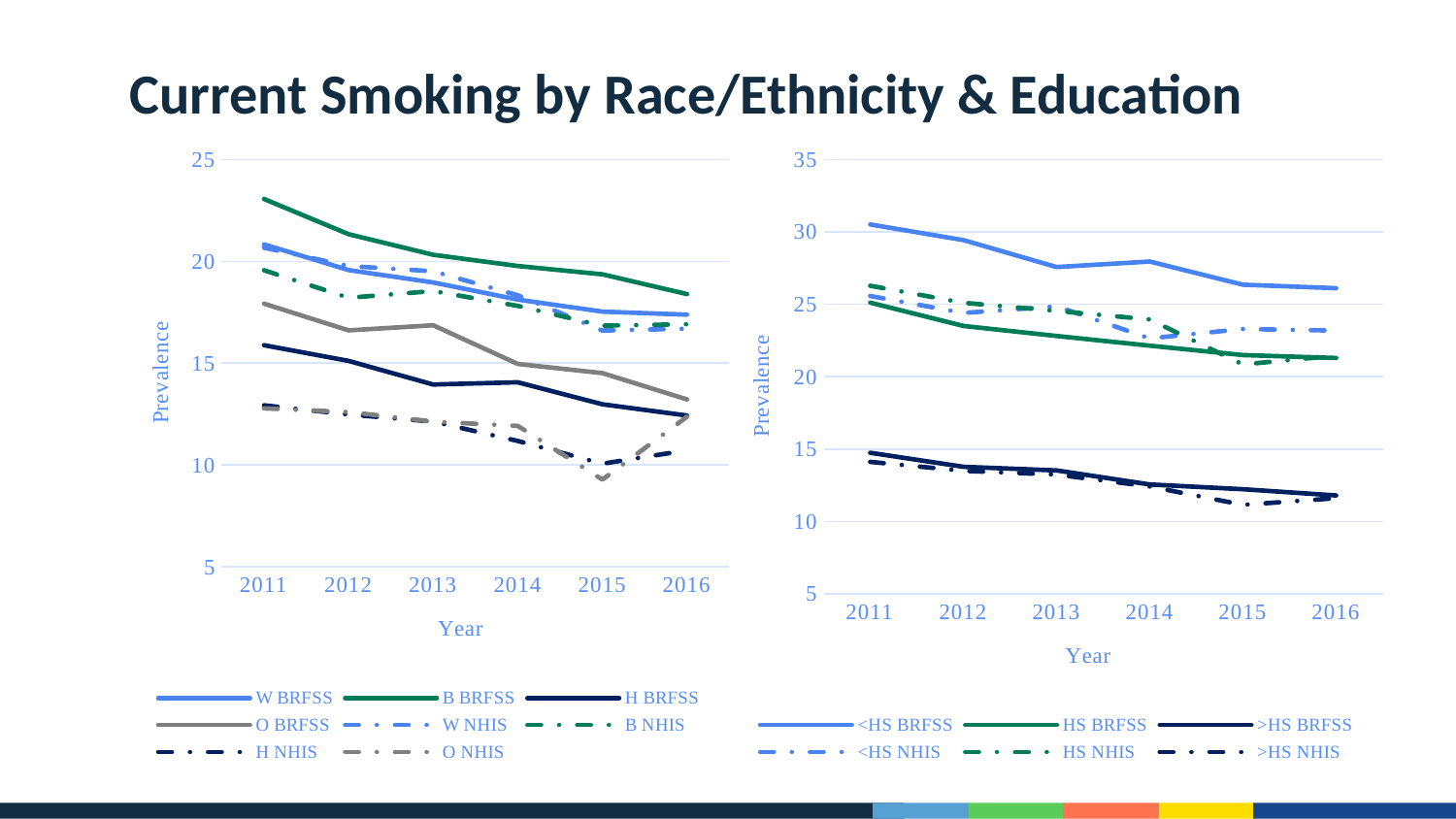
In the right chart, which series has the highest value in 2016? <HS BRFSS How many years are shown on the x axis of the right chart? 6 How many series does the legend of the right chart list? 6 How many series does the legend of the left chart list? 8 In the left chart, which series has the lowest value in 2015? O NHIS In the left chart, is the value for W BRFSS in 2011 greater or less than 20? greater What kind of chart is the left chart on the slide? line chart In the right chart, is the value for <HS BRFSS in 2011 greater or less than 30? greater In the right chart, is the value for >HS BRFSS in 2016 greater or less than 15? less In the right chart, does the <HS BRFSS series rise or fall from 2011 to 2016? fall In the left chart, which series has the highest value in 2011? B BRFSS